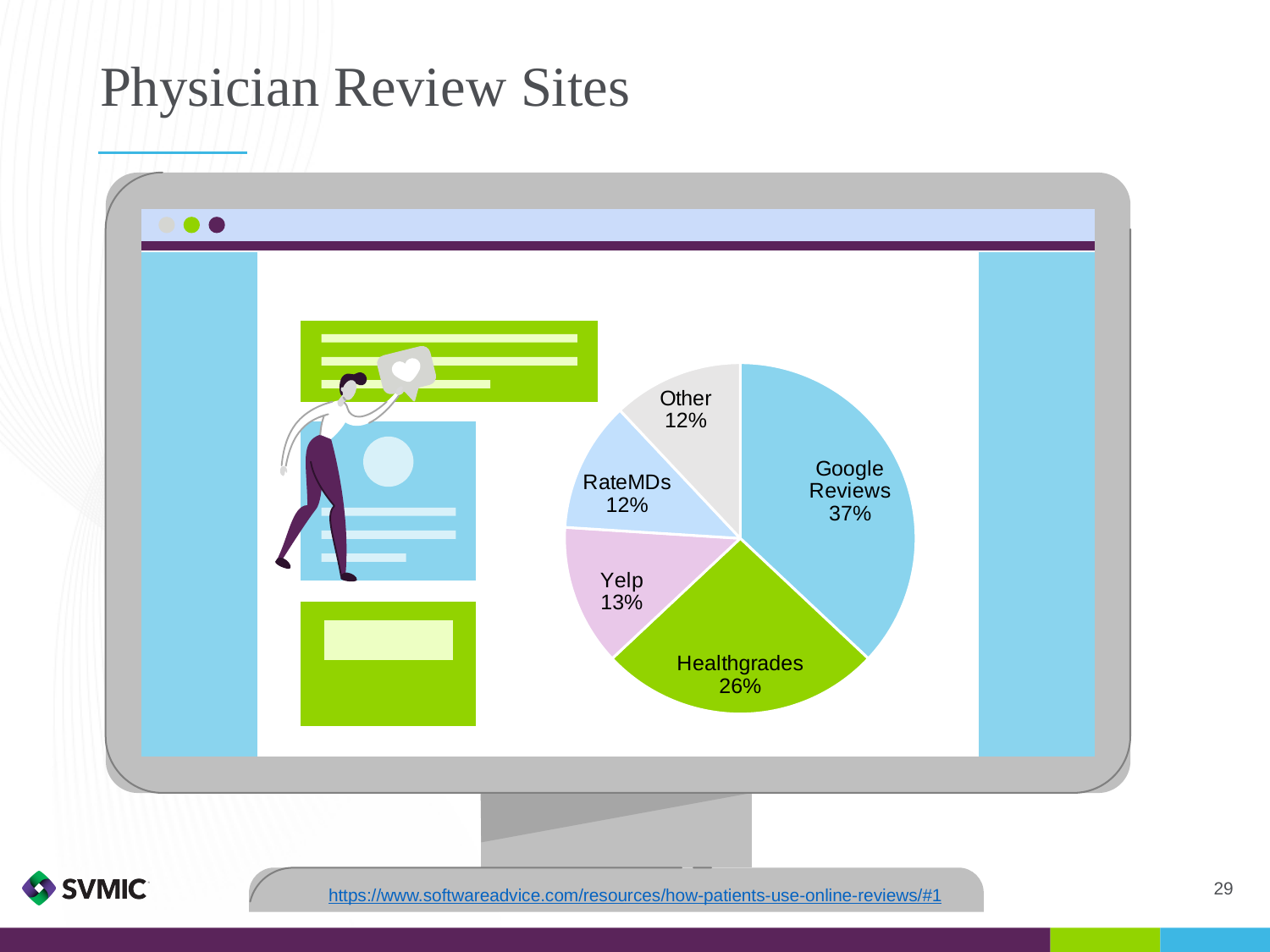
Which slice of the pie is the largest? Google Reviews What share of the pie does RateMDs have? 12% What share of the pie does Healthgrades have? 26% Which is larger, the Yelp slice or the RateMDs slice? Yelp What is the difference between the Google Reviews share and the Healthgrades share? 11% What share of the pie does Google Reviews have? 37% What is the combined share of Google Reviews and Healthgrades? 63% What share of the pie does Yelp have? 13% How many slices does the pie chart have? 5 What kind of chart is shown on the slide? pie chart What colour is the Healthgrades slice? green What share of the pie does Other have? 12%